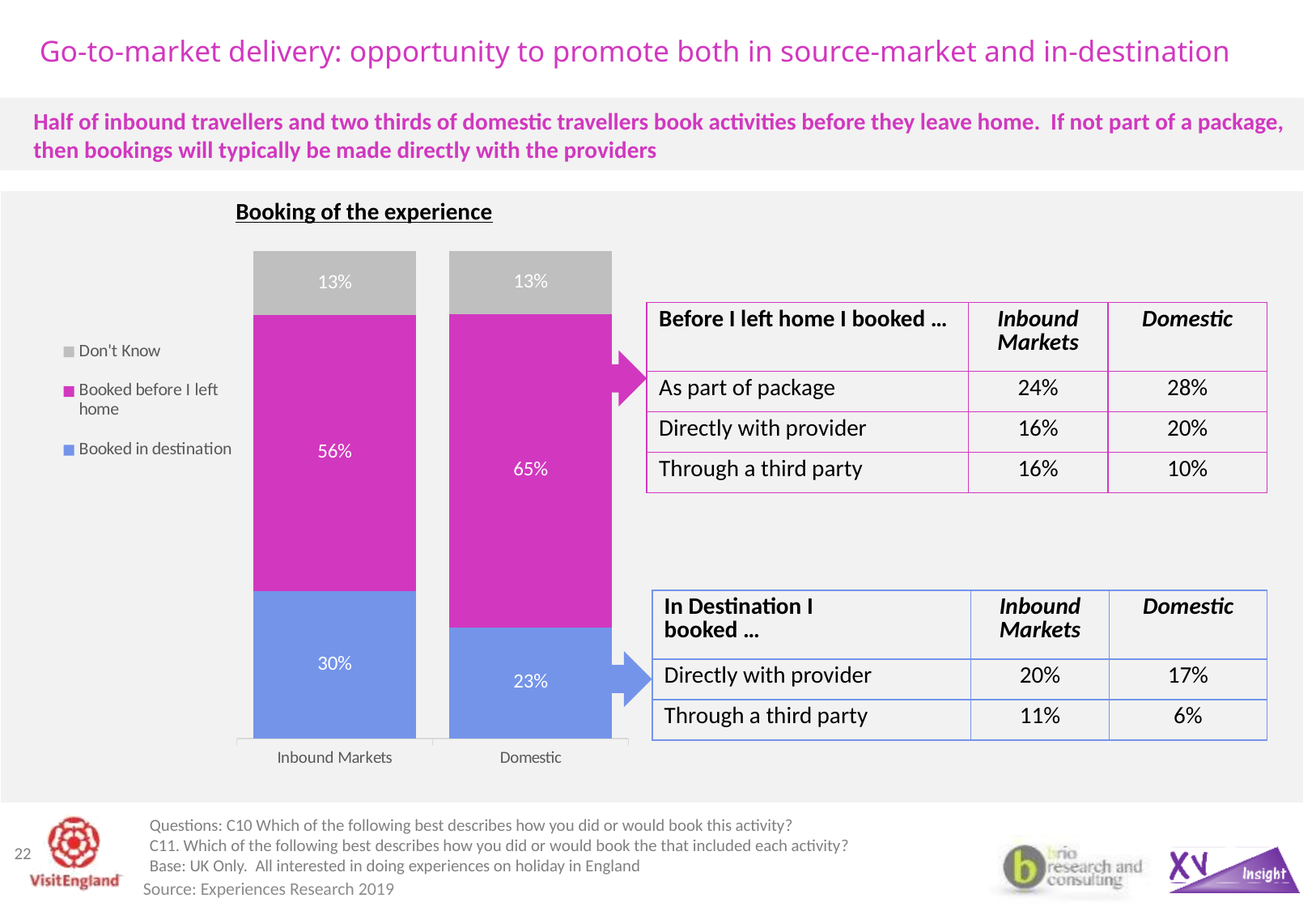
What percentage of Inbound Markets travellers booked before they left home? 56% What is the 'Don't Know' share for Domestic travellers? 13% What percentage of Domestic travellers booked in destination? 23% What is the difference between the 'Booked before I left home' shares for Domestic and Inbound Markets? 9 percentage points Which colour represents 'Booked in destination' in the chart? Blue What is the total of the stacked bar for Inbound Markets? 99% How many categories are shown on the x axis of the chart? 2 What is the difference between the 'Booked in destination' shares for Inbound Markets and Domestic? 7 percentage points Which category has the higher 'Booked before I left home' share, Inbound Markets or Domestic? Domestic What is the title of the chart? Booking of the experience What type of chart is shown on the slide? Stacked bar chart How many series does the chart legend list? 3